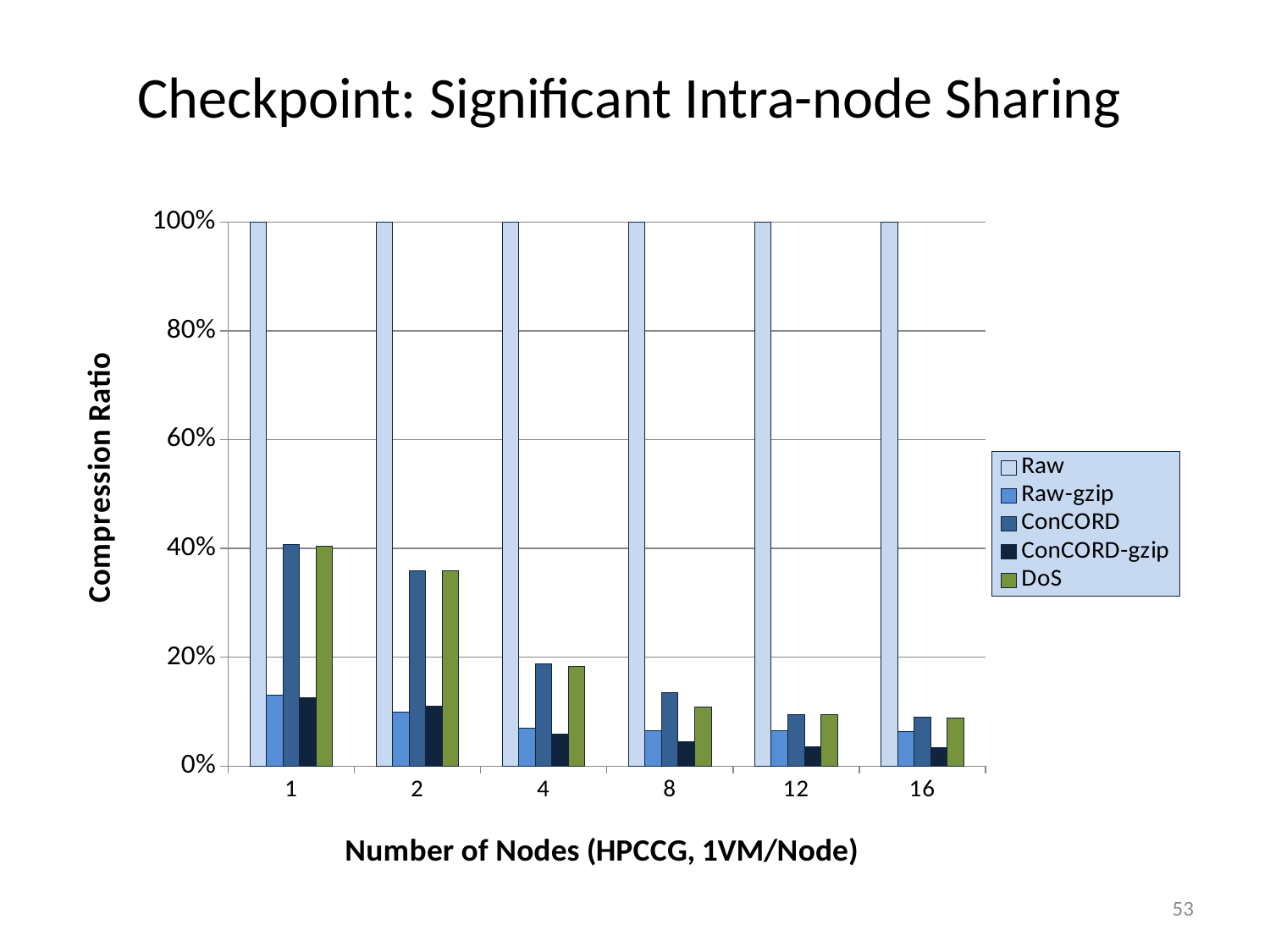
How many series does the legend list? 5 Is the value for ConCORD at 16 nodes greater or less than 20%? less What kind of chart is shown on the slide? bar chart What is the compression ratio for the Raw series at 1 node? 100% Is the value for ConCORD at 1 node greater or less than 20%? greater Is the value for Raw-gzip at 1 node greater or less than 20%? less Do the ConCORD values rise or fall as the number of nodes increases? fall How many node-count categories are shown on the x axis? 6 What is the label of the x axis? Number of Nodes (HPCCG, 1VM/Node) At 1 node, which is larger: ConCORD or Raw-gzip? ConCORD Which series has the lowest value at 16 nodes? ConCORD-gzip